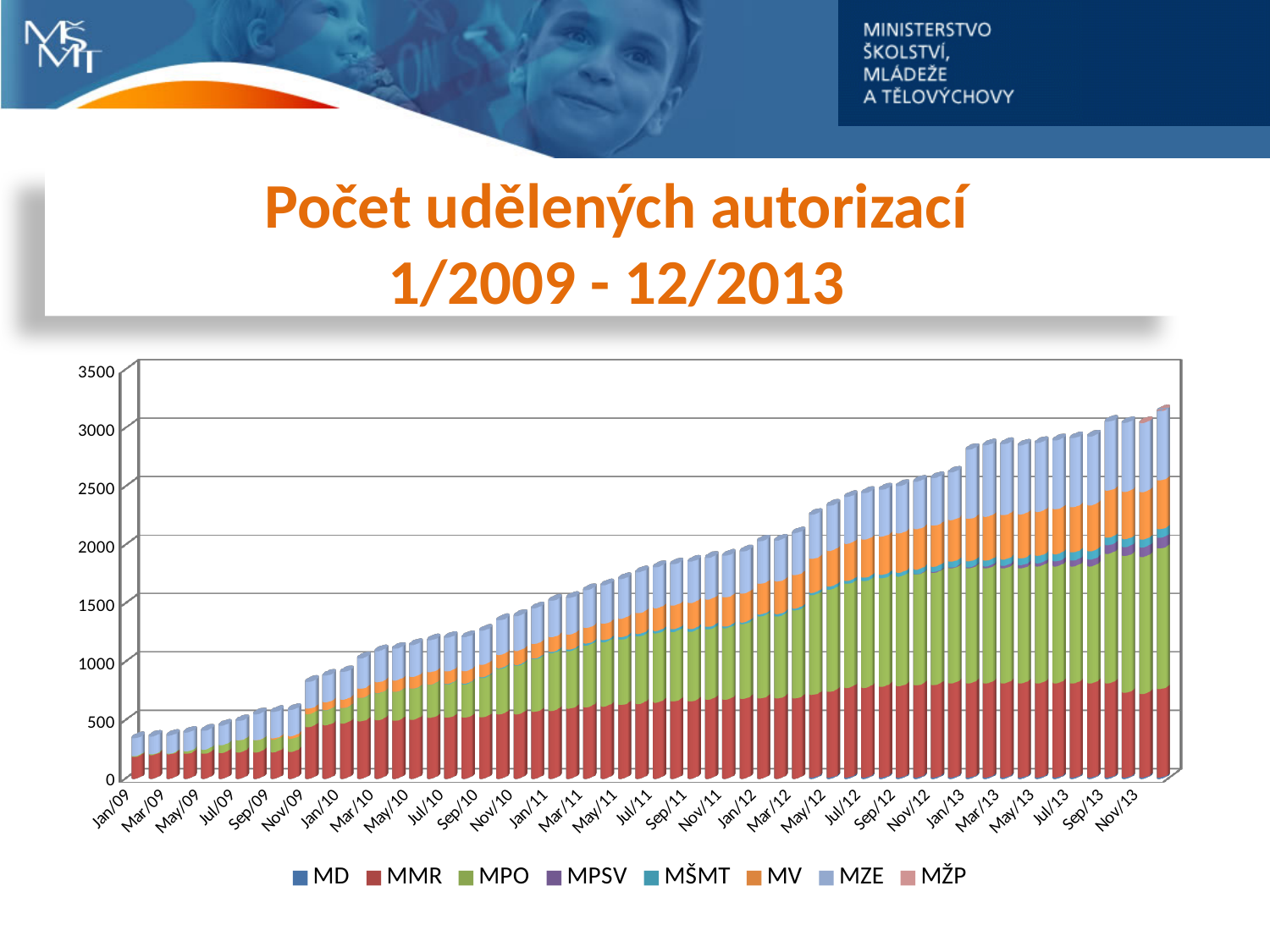
Which series is shown at the bottom of each stacked bar? MMR Which labelled month has the lowest total bar? Jan/09 What is the title of the chart on the slide? Počet udělených autorizací 1/2009 - 12/2013 Is the total for Jan/10 greater or less than 1000? less Is the total for Jan/13 greater or less than 2500? greater Do the total bar heights generally rise or fall from Jan/09 to Nov/13? rise Is the total for Jul/11 greater or less than 1500? greater How many series does the legend list? 8 What kind of chart is shown on the slide? stacked bar chart Which has the larger total bar, Jan/12 or Jan/13? Jan/13